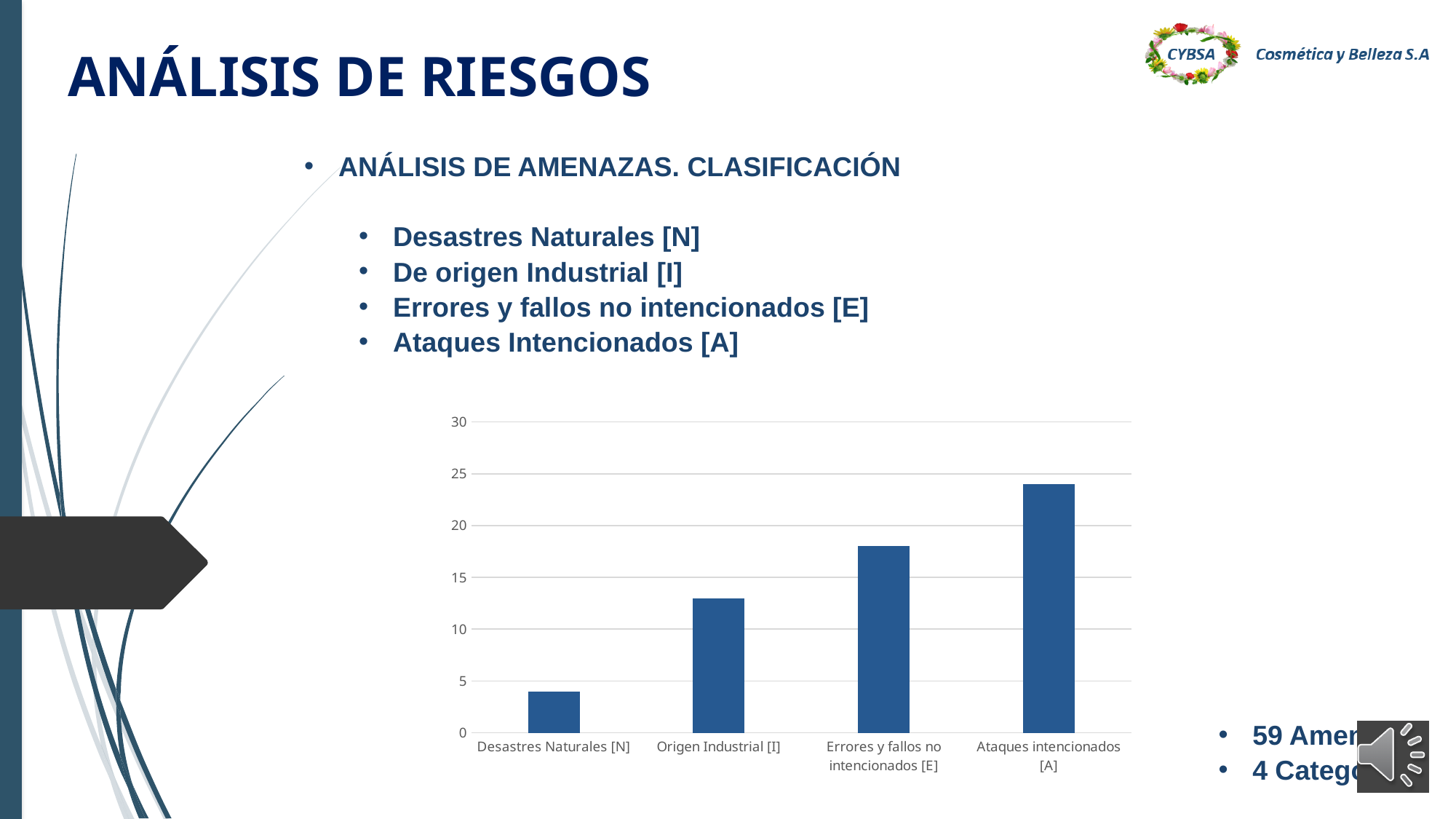
Which is larger, the value for Origen Industrial [I] or the value for Errores y fallos no intencionados [E]? Errores y fallos no intencionados [E] Is the value for Origen Industrial [I] greater or less than 10? greater What is the highest value shown on the vertical axis of the chart? 30 Which is larger, the value for Desastres Naturales [N] or the value for Ataques intencionados [A]? Ataques intencionados [A] Which category has the highest bar in the chart? Ataques intencionados [A] What kind of chart is shown on the slide? bar chart Do the bar values rise or fall from left to right along the x axis? rise Is the value for Errores y fallos no intencionados [E] greater or less than 20? less How many categories are shown on the x axis of the chart? 4 Is the value for Ataques intencionados [A] greater or less than 20? greater Which category has the lowest bar in the chart? Desastres Naturales [N]